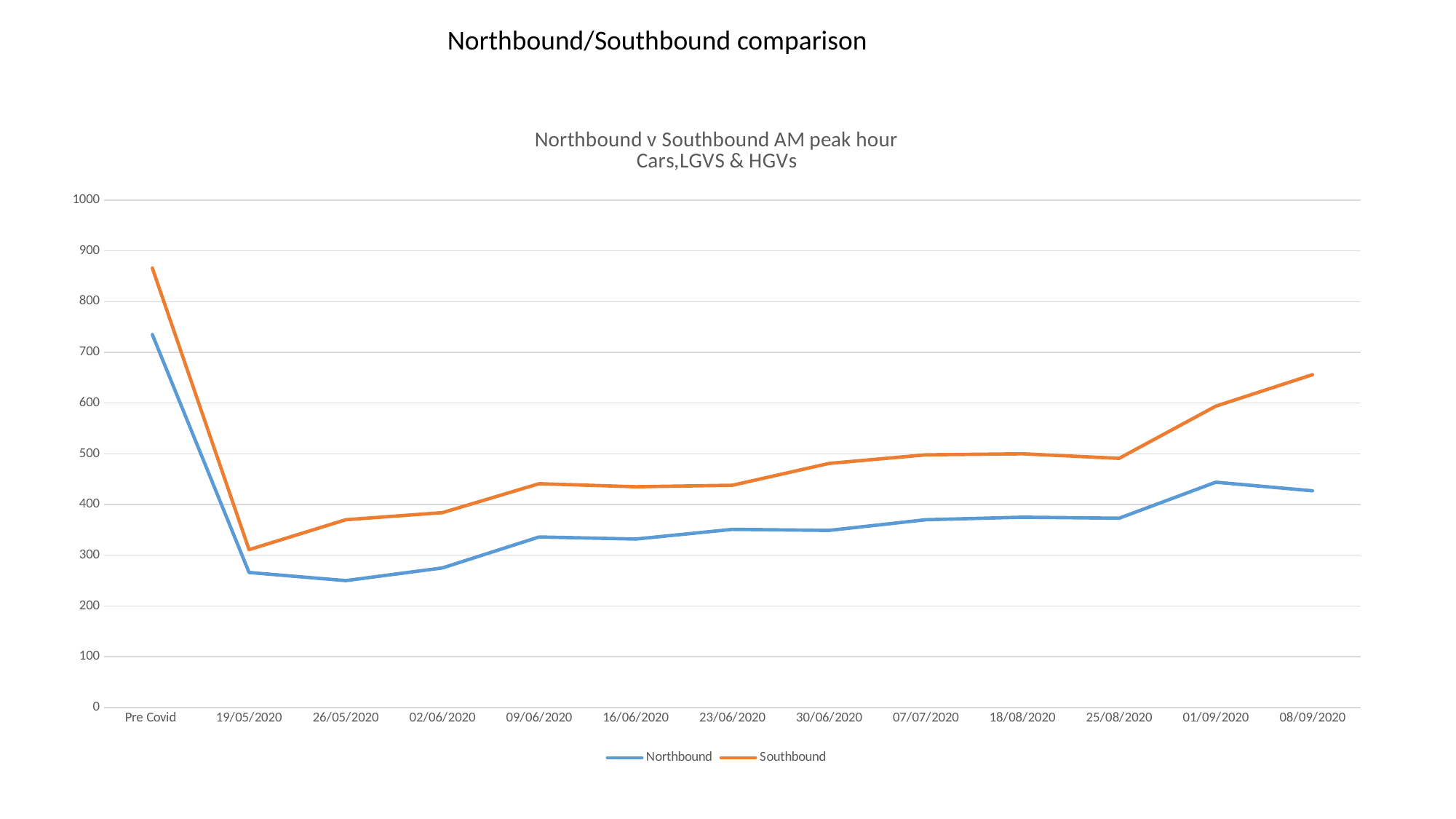
How many series does the legend list? 2 What kind of chart is shown on the slide? Line chart At Pre Covid, which series has the larger value, Northbound or Southbound? Southbound Does the Southbound series rise or fall from 25/08/2020 to 08/09/2020? rise At which x-axis category is the Northbound series lowest? 26/05/2020 At which x-axis category is the Southbound series highest? Pre Covid What colour is the Southbound line in the legend? Orange Is the Southbound value for 08/09/2020 greater or less than 600? greater Is the Southbound value for Pre Covid greater or less than 800? greater Is the Northbound value for 19/05/2020 greater or less than 300? less How many points are plotted along the x axis for each series? 13 At which x-axis category is the Southbound series lowest? 19/05/2020